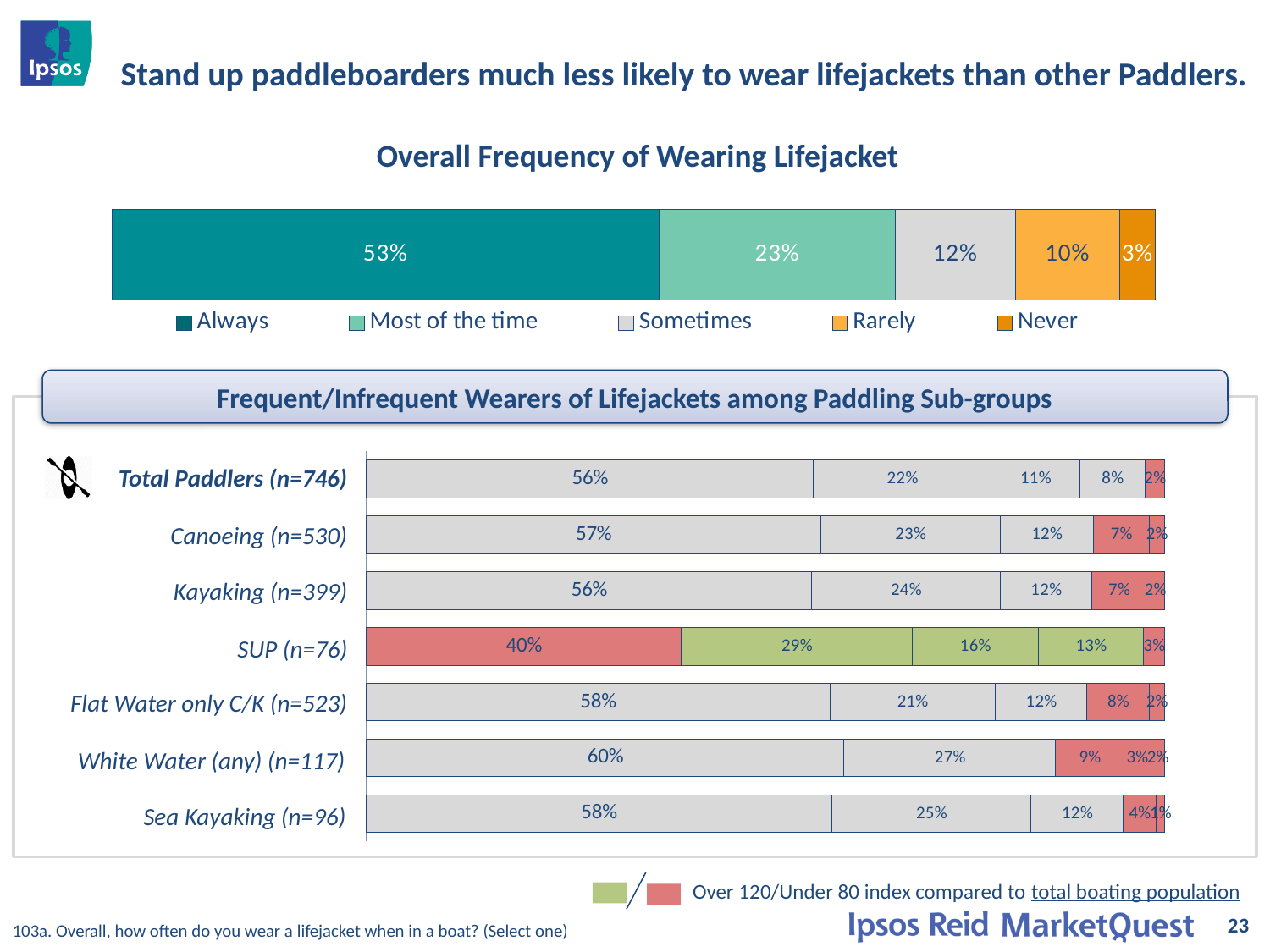
In the Frequent/Infrequent Wearers of Lifejackets among Paddling Sub-groups chart, how many paddling sub-groups are shown? 7 In the Frequent/Infrequent Wearers of Lifejackets among Paddling Sub-groups chart, what is the value of the first (largest) segment for SUP (n=76)? 40% In the Frequent/Infrequent Wearers of Lifejackets among Paddling Sub-groups chart, which sub-group has the highest value in its first segment? White Water (any) (n=117) In the Overall Frequency of Wearing Lifejacket chart, what percentage of respondents say they Always wear a lifejacket? 53% In the Frequent/Infrequent Wearers of Lifejackets among Paddling Sub-groups chart, which sub-group has the lowest value in its first segment? SUP (n=76) In the Overall Frequency of Wearing Lifejacket chart, which is larger, Sometimes or Rarely? Sometimes In the Overall Frequency of Wearing Lifejacket chart, what is the difference between the Always and Most of the time percentages? 30% In the Frequent/Infrequent Wearers of Lifejackets among Paddling Sub-groups chart, what is the value of the second segment for Kayaking (n=399)? 24% In the Overall Frequency of Wearing Lifejacket chart, which response category has the largest share? Always In the Overall Frequency of Wearing Lifejacket chart, how many categories does the legend list? 5 In the Overall Frequency of Wearing Lifejacket chart, what percentage say they Never wear a lifejacket? 3% What kind of chart is used for Frequent/Infrequent Wearers of Lifejackets among Paddling Sub-groups? Stacked bar chart